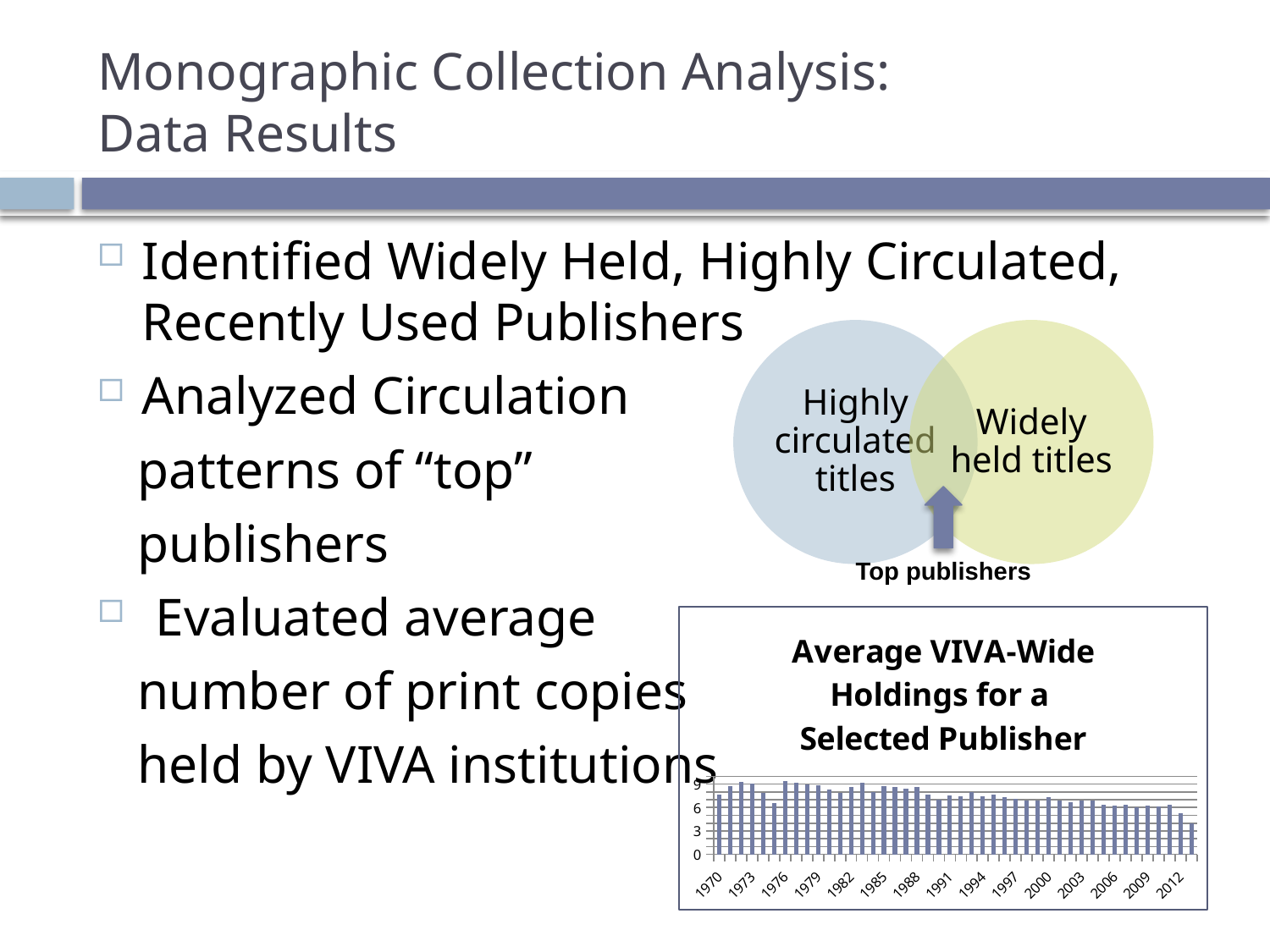
What is the last year labelled on the x-axis of the 'Average VIVA-Wide Holdings for a Selected Publisher' chart? 2012 What is the first year labelled on the x-axis of the 'Average VIVA-Wide Holdings for a Selected Publisher' chart? 1970 What is the highest tick value shown on the y-axis of the 'Average VIVA-Wide Holdings for a Selected Publisher' chart? 9 In the 'Average VIVA-Wide Holdings for a Selected Publisher' chart, is the value for 1970 greater or less than 6? greater In the 'Average VIVA-Wide Holdings for a Selected Publisher' chart, do the values generally rise or fall from 1970 to 2012? fall In the 'Average VIVA-Wide Holdings for a Selected Publisher' chart, is the value for 2012 greater or less than 6? less How many year labels are shown on the x-axis of the 'Average VIVA-Wide Holdings for a Selected Publisher' chart? 15 What kind of chart is shown at the bottom right of the slide? bar chart What is the title of the chart on the slide? Average VIVA-Wide Holdings for a Selected Publisher In the 'Average VIVA-Wide Holdings for a Selected Publisher' chart, which is larger, the value for 1976 or the value for 2012? 1976 In the 'Average VIVA-Wide Holdings for a Selected Publisher' chart, is the value for 1976 greater or less than 6? greater